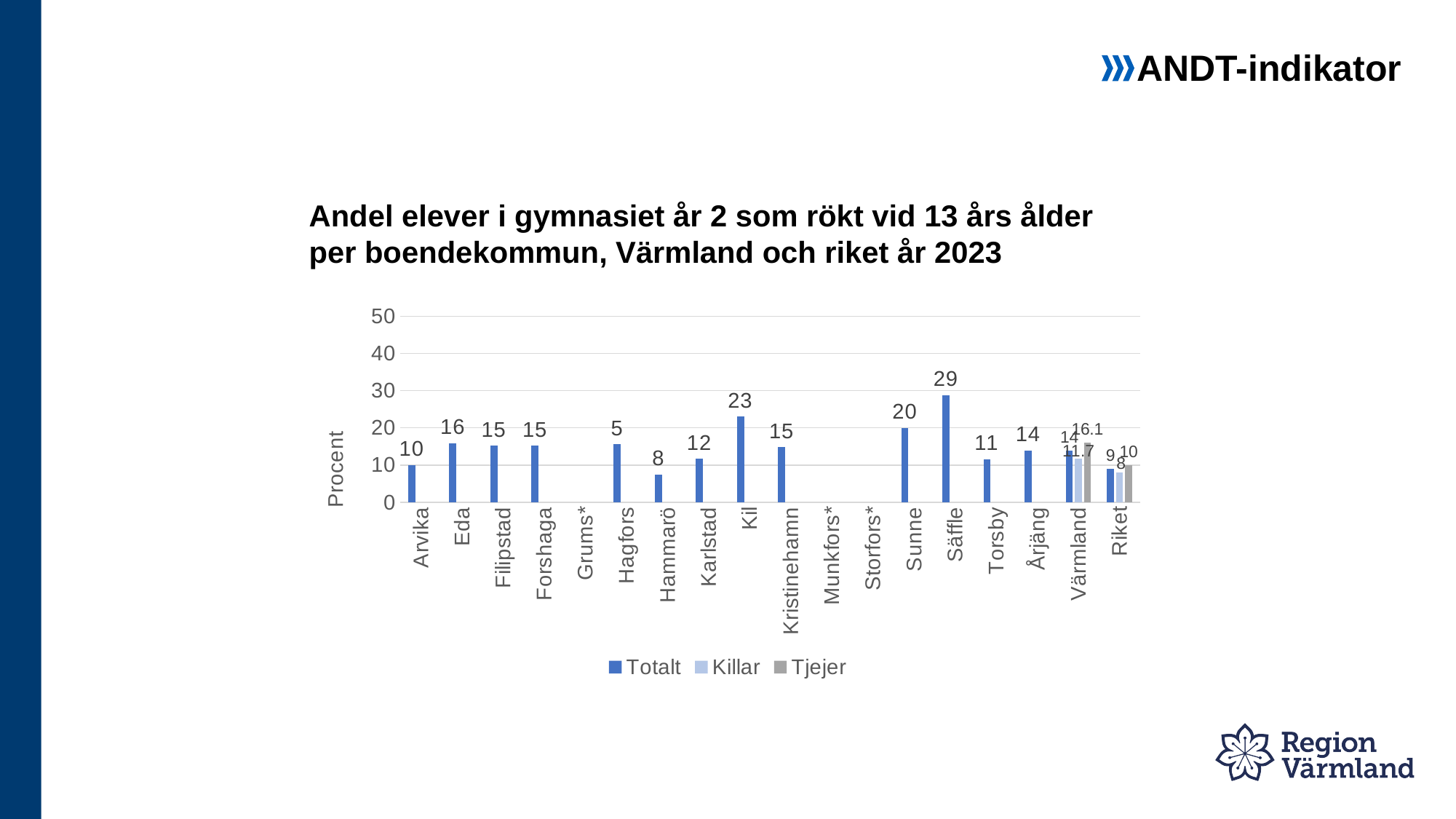
What is the Totalt value for Säffle? 29 What is the label on the y axis? Procent Which has a higher Totalt value, Sunne or Eda? Sunne What is the Tjejer value for Värmland? 16.1 How many categories are shown on the x axis? 18 How many series does the legend list? 3 What is the Totalt value for Kil? 23 Is the Totalt value for Kil greater or less than 20? greater What is the difference between the Totalt values for Säffle and Kil? 6 What is the Killar value for Riket? 8 Which municipality has the highest Totalt value? Säffle What kind of chart is shown on the slide? Bar chart